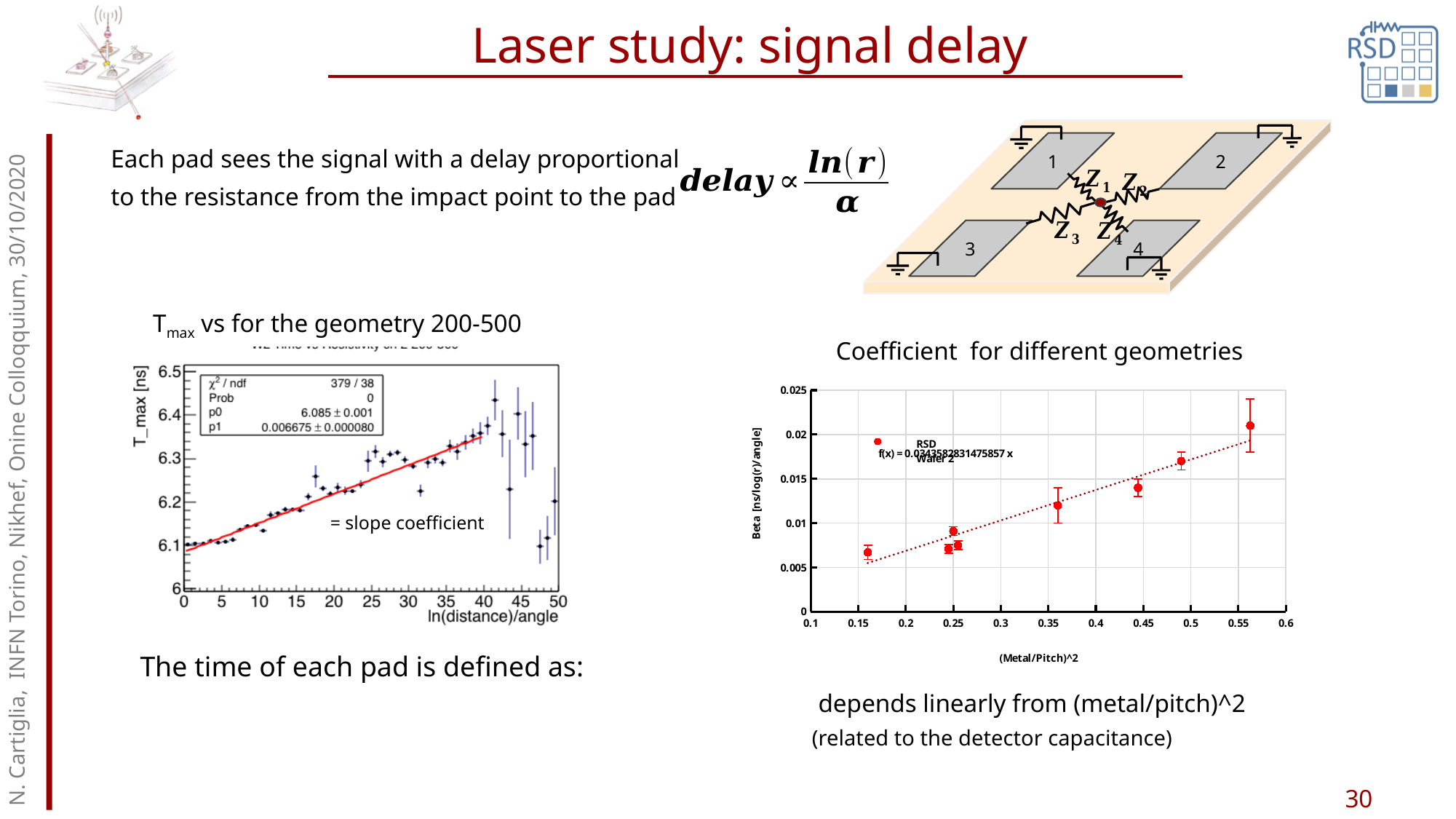
In the T_max chart on the left, is the T_max value at ln(distance)/angle = 0 greater or less than 6.2? less What kind of chart is the 'Coefficient for different geometries' chart on the right? scatter plot In the 'Coefficient for different geometries' chart, is the Beta value of the point at the smallest (Metal/Pitch)^2 greater or less than 0.01? less In the T_max chart on the left, what is the value of the fit parameter p0? 6.085 ± 0.001 In the 'Coefficient for different geometries' chart, what is the fitted function shown in the legend? f(x) = 0.0343582831475857 x In the 'Coefficient for different geometries' chart, how many data points are plotted? 8 In the T_max chart on the left, what is the chi2 / ndf of the fit? 379 / 38 In the 'Coefficient for different geometries' chart, what is the label of the x axis? (Metal/Pitch)^2 In the 'Coefficient for different geometries' chart, is the Beta value of the point at the largest (Metal/Pitch)^2 greater or less than 0.02? greater In the 'Coefficient for different geometries' chart, do the Beta values rise or fall as (Metal/Pitch)^2 increases? rise In the T_max chart on the left, do the T_max values rise or fall as ln(distance)/angle increases from 0 to 40? rise In the T_max chart on the left, what is the value of the fit parameter p1? 0.006675 ± 0.000080